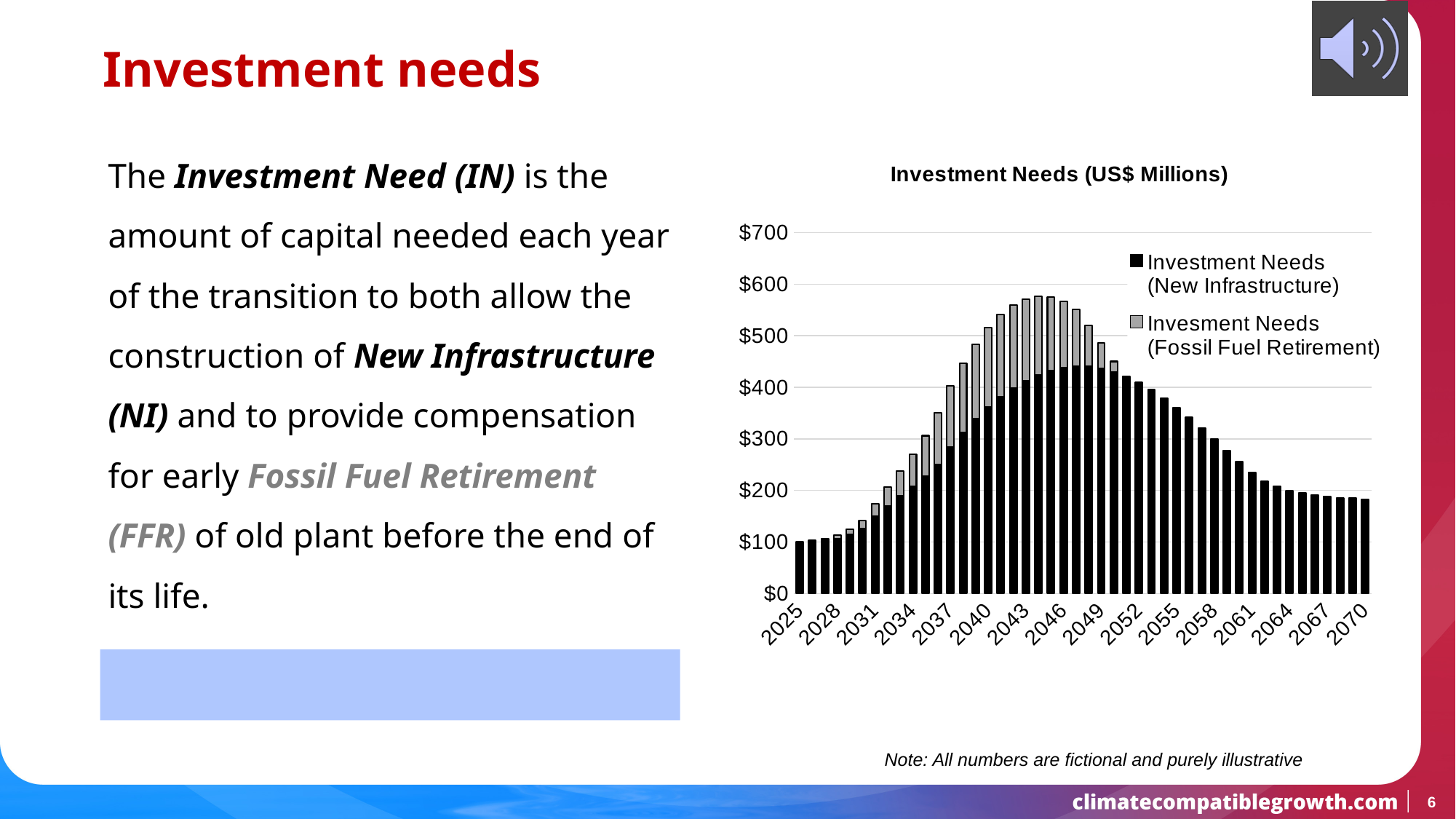
What kind of chart is shown on the slide? Stacked bar chart Is the total investment need for 2070 greater or less than $200? less How many year labels are shown on the x axis? 16 Which year has the larger total investment need, 2037 or 2058? 2037 Do the total investment needs rise or fall from 2049 to 2070? Fall Is the total investment need for 2034 greater or less than $200? greater Is the tallest bar in the chart greater or less than $500? greater How many series does the chart legend list? 2 Which year has the lowest total investment need? 2025 What is the title of the chart? Investment Needs (US$ Millions) Which series is shown in grey in the chart? Invesment Needs (Fossil Fuel Retirement)